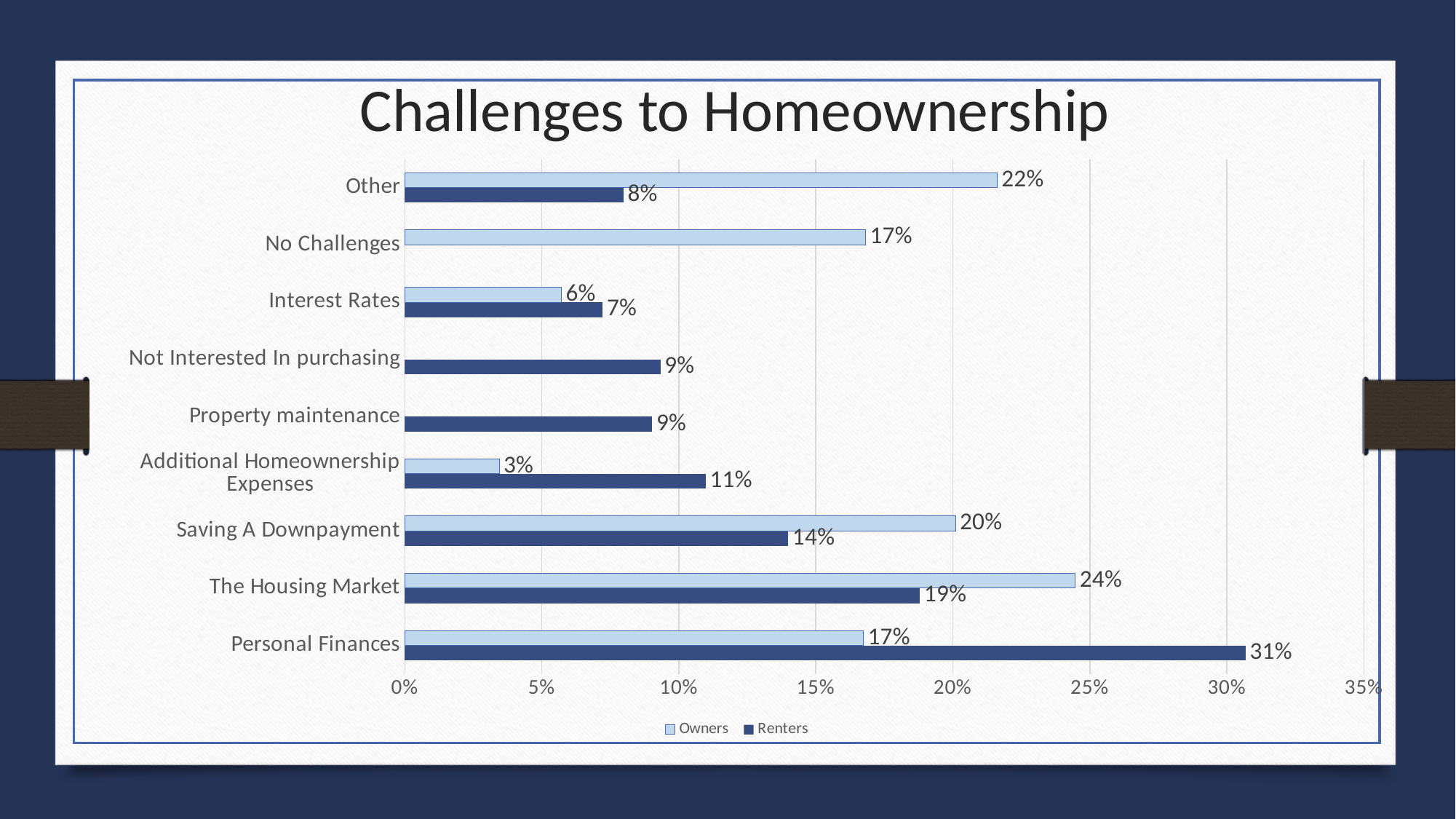
What is the difference between the Renters and Owners values for Personal Finances? 14% How many categories are shown on the y axis? 9 Which category has the lowest Owners value among those with an Owners bar? Additional Homeownership Expenses What is the Renters value for Personal Finances? 31% What is the title of the chart? Challenges to Homeownership Which category has the highest Renters value? Personal Finances What is the Owners value for Additional Homeownership Expenses? 3% Is the Renters value for The Housing Market greater or less than 15%? greater What kind of chart is shown on the slide? Bar chart What is the Owners value for The Housing Market? 24% How many series does the legend list? 2 Which is larger for Saving A Downpayment, the Owners value or the Renters value? Owners